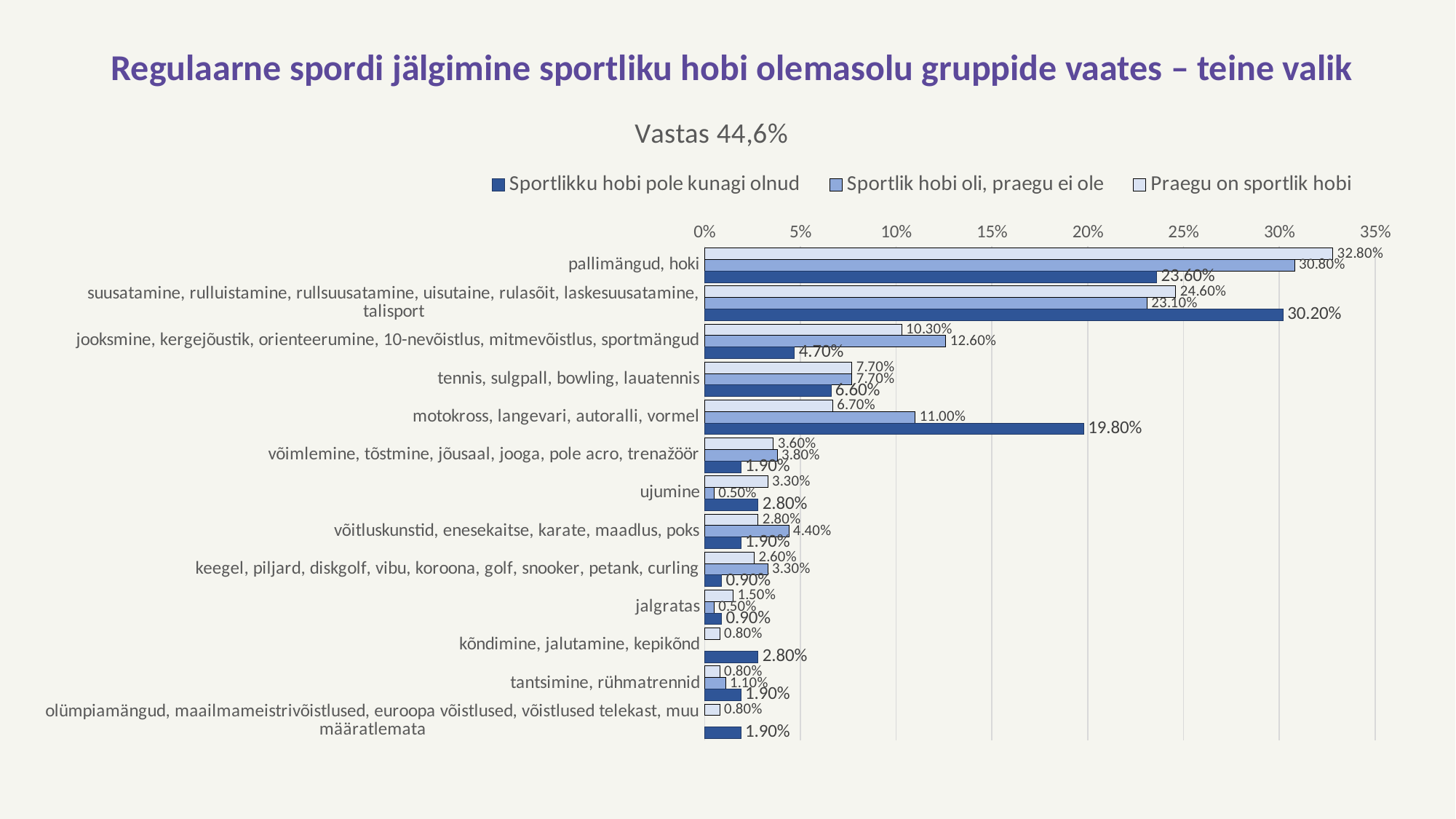
How many categories are plotted on the chart? 13 What kind of chart is shown on the slide? bar chart What is the difference between the "Sportlik hobi oli, praegu ei ole" and "Sportlikku hobi pole kunagi olnud" values for "jooksmine, kergejõustik, orienteerumine, 10-nevõistlus, mitmevõistlus, sportmängud"? 7.90% What is the value for "pallimängud, hoki" in the "Praegu on sportlik hobi" series? 32.80% What is the subtitle shown above the legend? Vastas 44,6% Which category has the highest value in the "Sportlikku hobi pole kunagi olnud" series? suusatamine, rulluistamine, rullsuusatamine, uisutaine, rulasõit, laskesuusatamine, talisport Is the "Sportlikku hobi pole kunagi olnud" value for "suusatamine, rulluistamine, rullsuusatamine, uisutaine, rulasõit, laskesuusatamine, talisport" greater or less than 25%? greater What is the value for "motokross, langevari, autoralli, vormel" in the "Sportlikku hobi pole kunagi olnud" series? 19.80% What is the value for "võitluskunstid, enesekaitse, karate, maadlus, poks" in the "Sportlik hobi oli, praegu ei ole" series? 4.40% How many series does the legend list? 3 What is the value for "ujumine" in the "Sportlik hobi oli, praegu ei ole" series? 0.50% For "pallimängud, hoki", which series has the larger value: "Praegu on sportlik hobi" or "Sportlikku hobi pole kunagi olnud"? Praegu on sportlik hobi